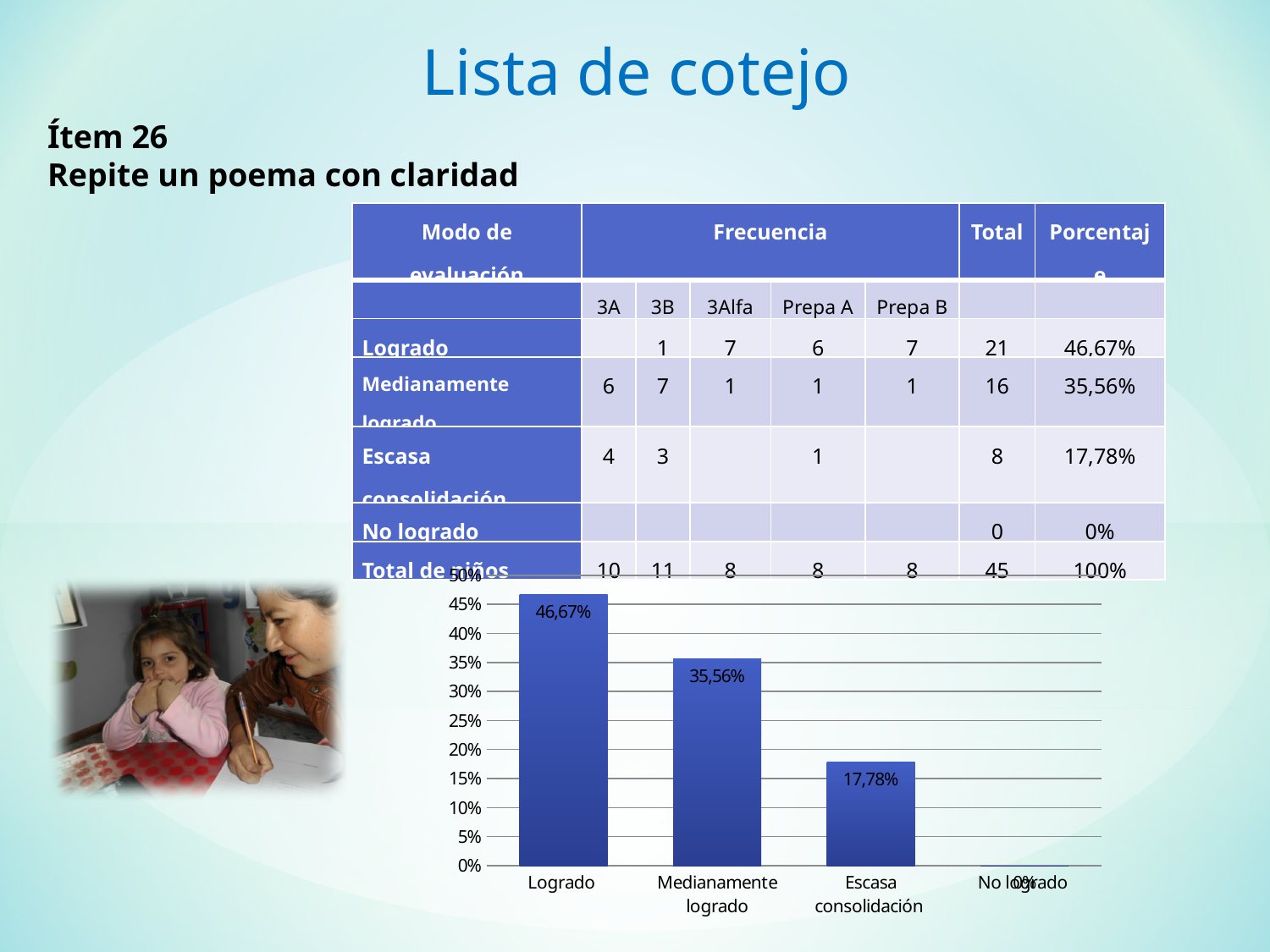
What is the difference between the values for Logrado and Medianamente logrado in the chart? 11,11% Do the values rise or fall from left to right along the x axis of the chart? fall Which is larger in the chart, Medianamente logrado or Escasa consolidación? Medianamente logrado What is the value for Logrado in the chart? 46,67% What type of chart is shown on the slide? bar chart What is the value for Escasa consolidación in the chart? 17,78% What is the value for No logrado in the chart? 0% How many categories are shown on the x axis of the chart? 4 What is the value for Medianamente logrado in the chart? 35,56% Is the value for Escasa consolidación greater or less than 20%? less Which category has the lowest value in the chart? No logrado Which category has the highest value in the chart? Logrado